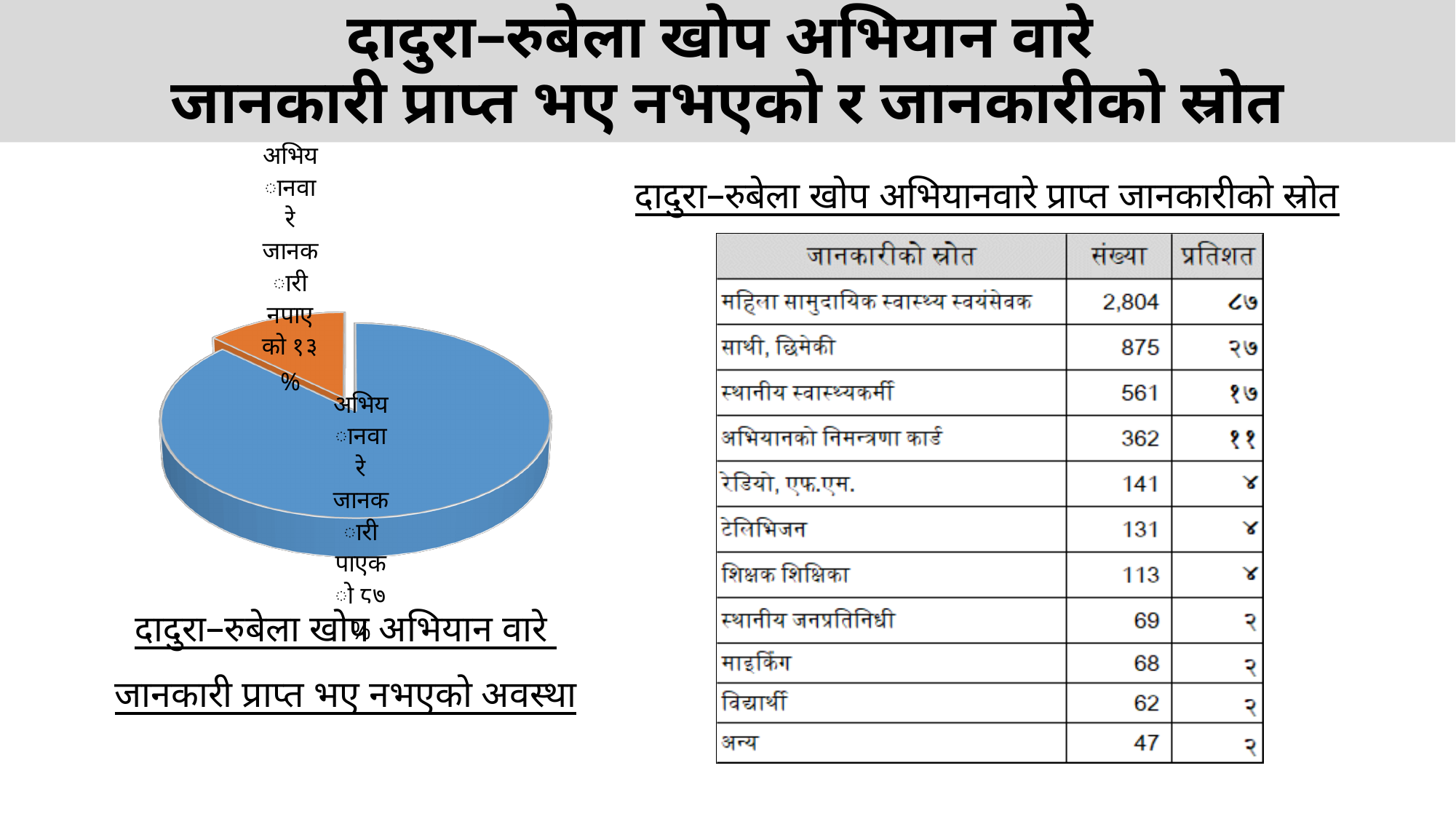
What kind of chart is shown on the left of the slide? pie chart In the pie chart, what share is labelled for अभियानवारे जानकारी पाएको? ८७% How many slices does the pie chart on the left have? 2 What colour is the slice for अभियानवारे जानकारी पाएको in the pie chart? blue In the pie chart, what share is labelled for अभियानवारे जानकारी नपाएको? १३% In the pie chart, which is larger: the slice for जानकारी पाएको or the slice for जानकारी नपाएको? जानकारी पाएको In the pie chart, what is the difference in percentage points between the जानकारी पाएको slice and the जानकारी नपाएको slice? ७४ Which slice of the pie chart is the smallest? अभियानवारे जानकारी नपाएको Which slice of the pie chart is the largest? अभियानवारे जानकारी पाएको What colour is the slice for अभियानवारे जानकारी नपाएको in the pie chart? orange